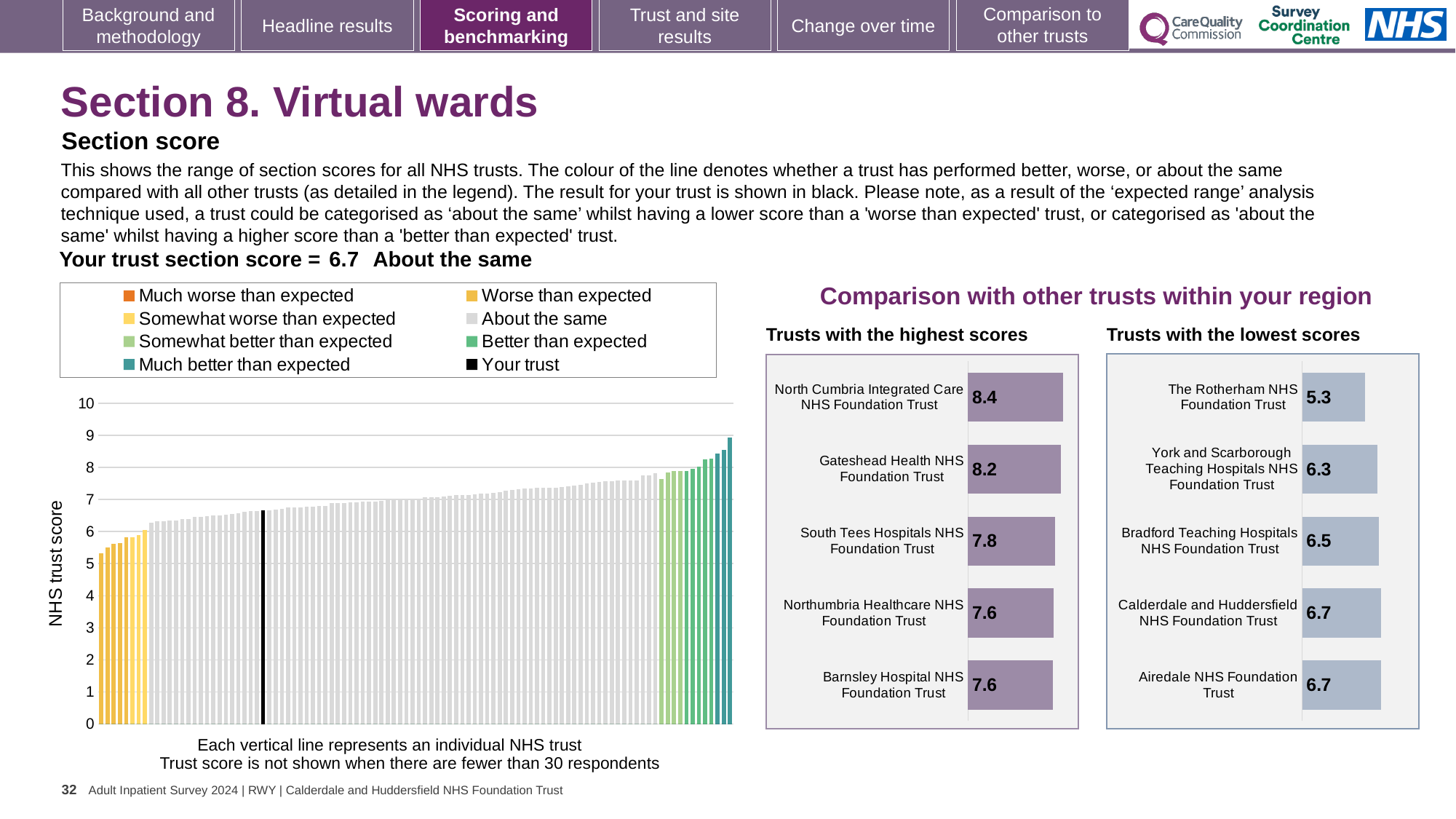
What kind of chart is the large chart on the left showing NHS trust scores? bar chart In the 'Trusts with the lowest scores' chart, what is the difference between the scores of Bradford Teaching Hospitals NHS Foundation Trust and The Rotherham NHS Foundation Trust? 1.2 In the 'Trusts with the highest scores' chart, what is the difference between the scores of North Cumbria Integrated Care NHS Foundation Trust and Gateshead Health NHS Foundation Trust? 0.2 In the large chart on the left, do the trust scores rise or fall from left to right? rise In the 'Trusts with the highest scores' chart, which trust has the highest score? North Cumbria Integrated Care NHS Foundation Trust In the 'Trusts with the highest scores' chart, what is the score for North Cumbria Integrated Care NHS Foundation Trust? 8.4 In the 'Trusts with the lowest scores' chart, how many trusts are shown? 5 In the 'Trusts with the lowest scores' chart, what is the score for The Rotherham NHS Foundation Trust? 5.3 In the large chart on the left, is the value of the black bar (your trust) greater or less than 6? greater In the 'Trusts with the highest scores' chart, which has the larger score: Gateshead Health NHS Foundation Trust or South Tees Hospitals NHS Foundation Trust? Gateshead Health NHS Foundation Trust In the large chart on the left, what is the label on the vertical axis? NHS trust score In the large chart on the left, how many entries does the legend list? 8